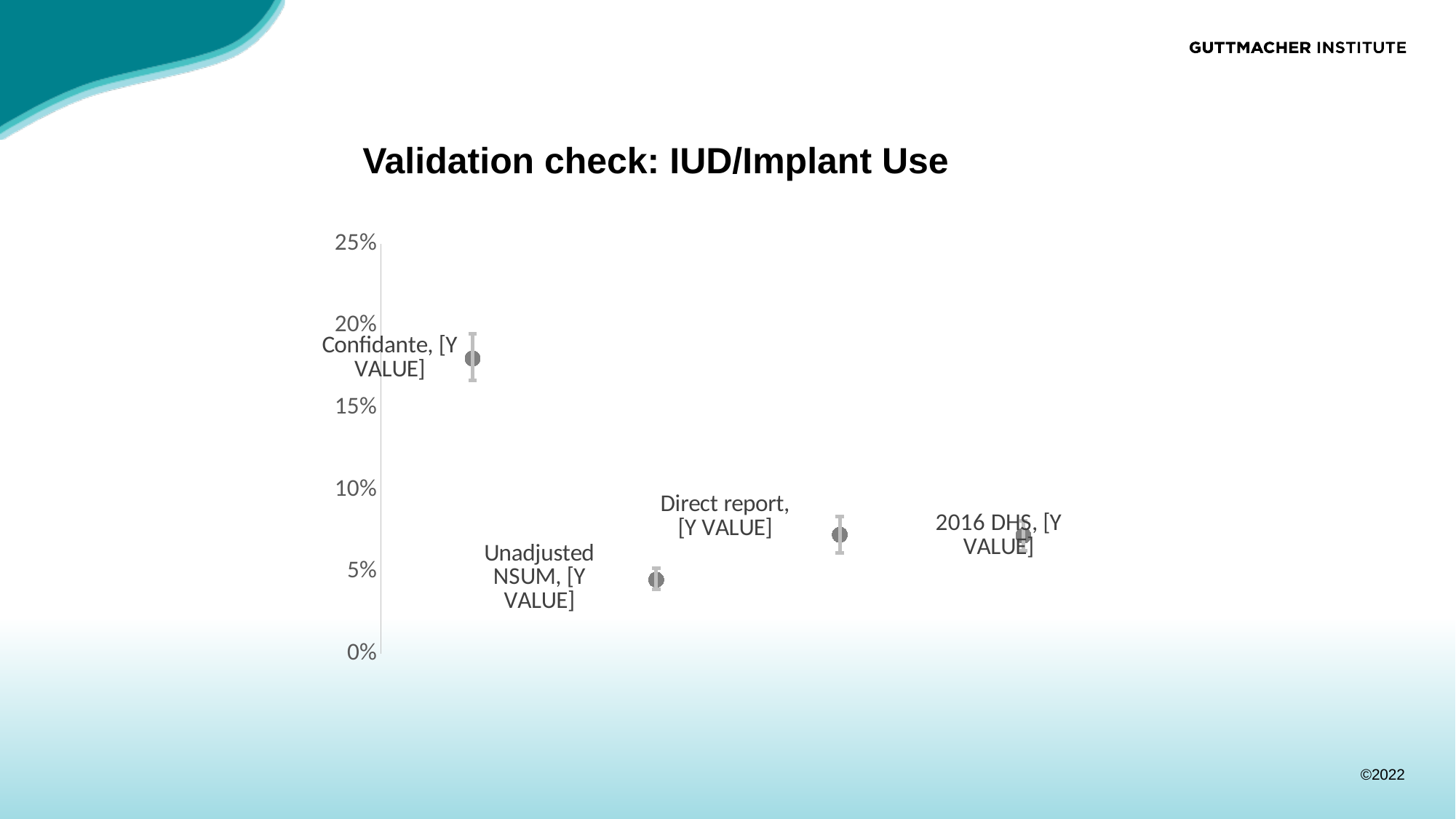
Which is larger, the value for Direct report or the value for Unadjusted NSUM? Direct report How many data points are plotted on the chart? 4 Which data point has the highest value? Confidante Is the value for 2016 DHS greater or less than 10%? less What is the title of the chart? Validation check: IUD/Implant Use Is the value for Direct report greater or less than 5%? greater Which is larger, the value for Confidante or the value for Unadjusted NSUM? Confidante What kind of chart is shown on the slide? Scatter chart Is the value for Confidante greater or less than 15%? greater Which data point has the lowest value? Unadjusted NSUM